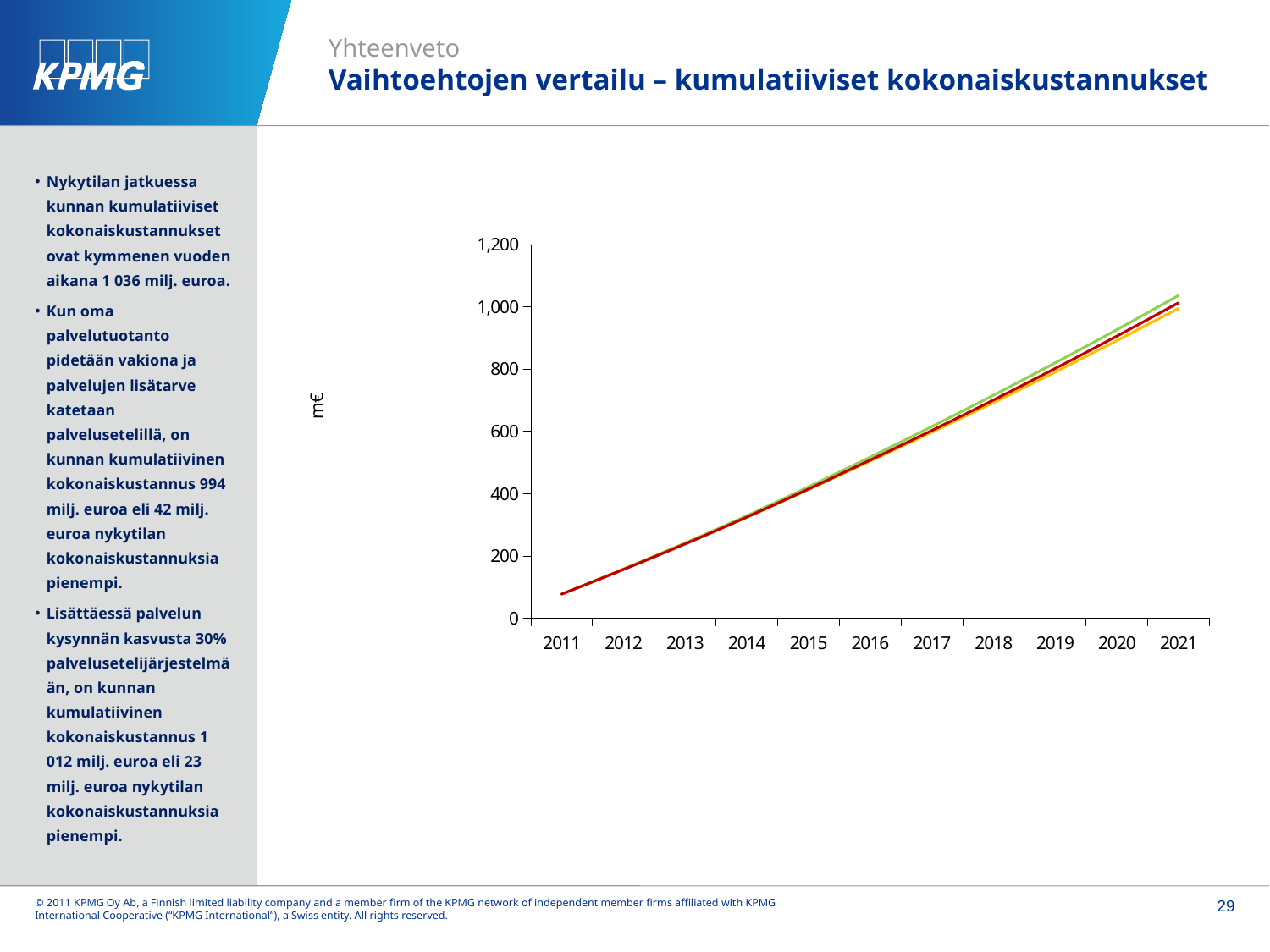
Is the value of the lines in 2011 greater or less than 200? less How many lines are plotted on the chart? 3 What kind of chart is shown on the slide? line chart In 2021, which line is higher, the green line or the yellow line? green line In which year do the lines reach their highest value? 2021 In which year do the lines have their lowest value? 2011 How many years are shown on the x axis of the chart? 11 Is the value of the lines in 2016 greater or less than 600? less Is the value of the lines in 2014 greater or less than 200? greater Do the values on the chart rise or fall from 2011 to 2021? rise What is the label on the y axis of the chart? m€